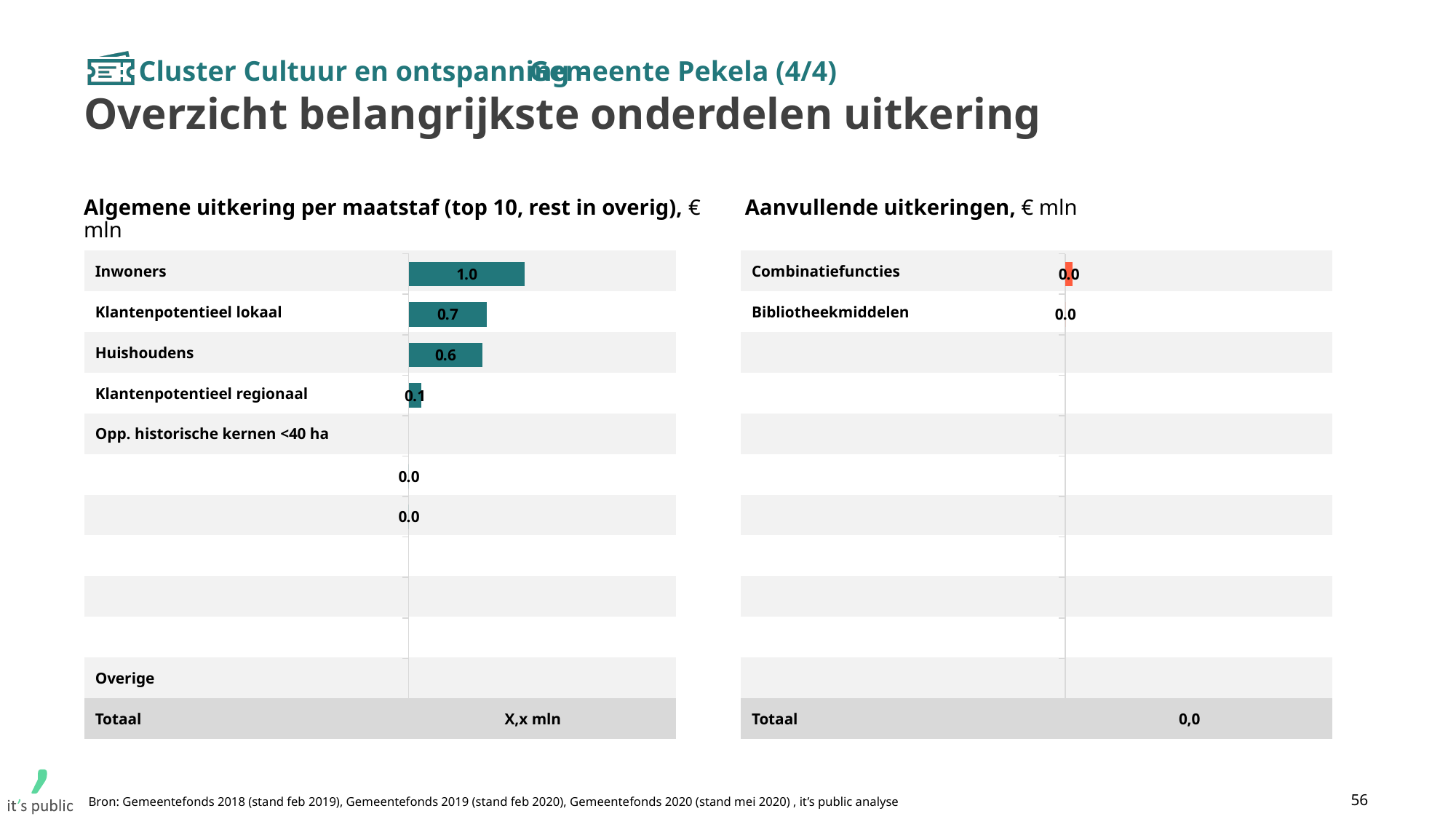
In the chart 'Algemene uitkering per maatstaf', what is the value for Klantenpotentieel lokaal? 0.7 What unit is stated in the title of the chart 'Aanvullende uitkeringen'? € mln In the chart 'Algemene uitkering per maatstaf', which is larger: Klantenpotentieel lokaal or Huishoudens? Klantenpotentieel lokaal In the chart 'Algemene uitkering per maatstaf', what is the difference between the values for Inwoners and Huishoudens? 0.4 What kind of chart is 'Algemene uitkering per maatstaf'? Bar chart In the chart 'Algemene uitkering per maatstaf', what is the value for Klantenpotentieel regionaal? 0.1 In the chart 'Aanvullende uitkeringen', what is the value for Bibliotheekmiddelen? 0.0 In the chart 'Algemene uitkering per maatstaf', what is the value for Inwoners? 1.0 In the chart 'Algemene uitkering per maatstaf', what is the value for Huishoudens? 0.6 In the chart 'Aanvullende uitkeringen', what is the value for Combinatiefuncties? 0.0 In the chart 'Algemene uitkering per maatstaf', what is the difference between Klantenpotentieel lokaal and Klantenpotentieel regionaal? 0.6 In the chart 'Algemene uitkering per maatstaf', which category has the highest value? Inwoners